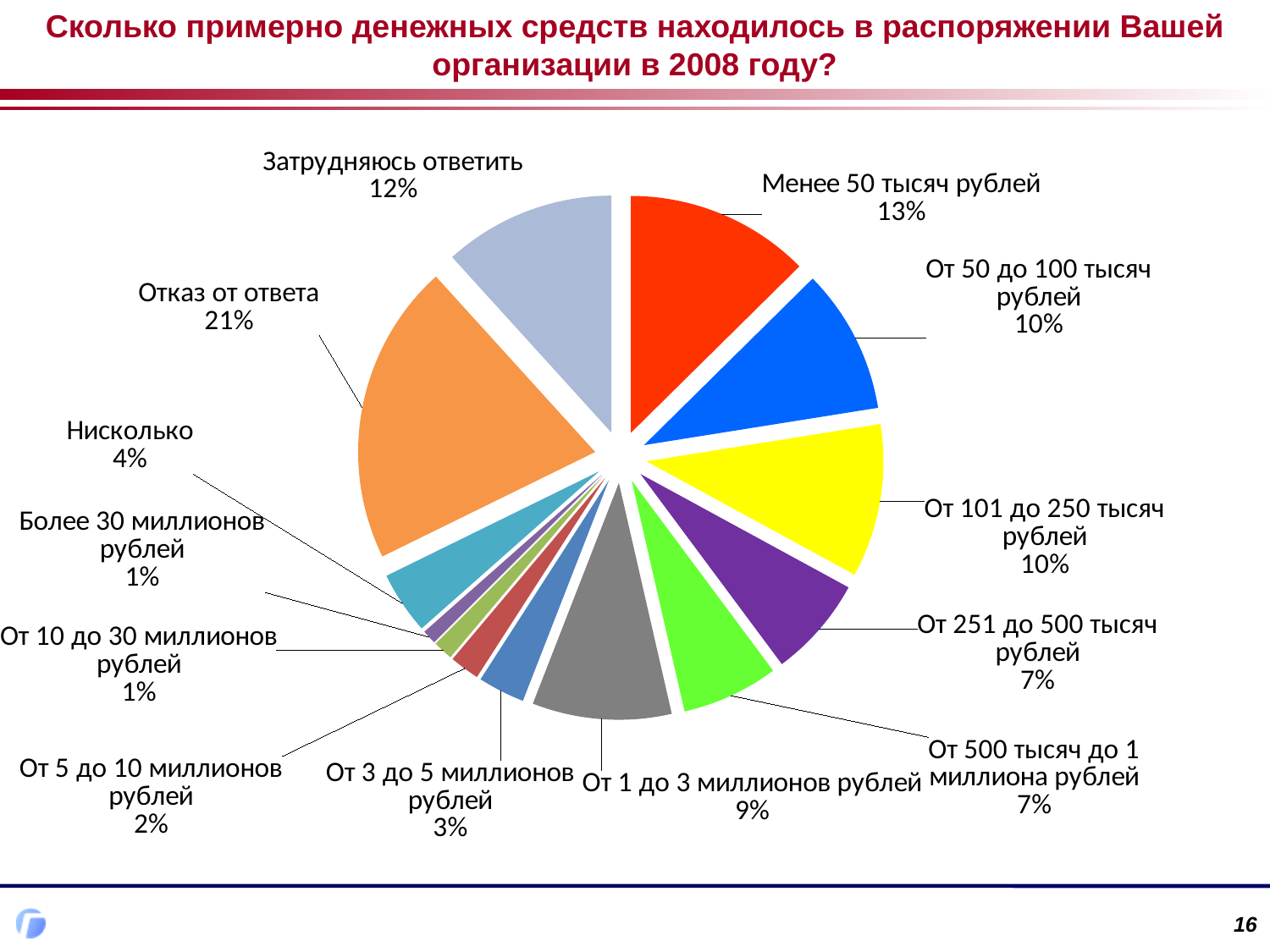
How many answer categories (slices) does the pie chart have? 13 Which is larger: the share for "От 1 до 3 миллионов рублей" or the share for "От 3 до 5 миллионов рублей"? От 1 до 3 миллионов рублей What share of respondents answered "Отказ от ответа"? 21% What is the title of the slide? Сколько примерно денежных средств находилось в распоряжении Вашей организации в 2008 году? Which answer category has the largest share of the pie? Отказ от ответа What kind of chart is shown on the slide? pie chart What share of respondents answered "От 5 до 10 миллионов рублей"? 2% What is the difference in percentage points between "Отказ от ответа" and "Затрудняюсь ответить"? 9 What share of respondents answered "От 1 до 3 миллионов рублей"? 9% What is the difference in percentage points between "Менее 50 тысяч рублей" and "От 251 до 500 тысяч рублей"? 6 What share of respondents answered "Нисколько"? 4% What share of respondents answered "Менее 50 тысяч рублей"? 13%